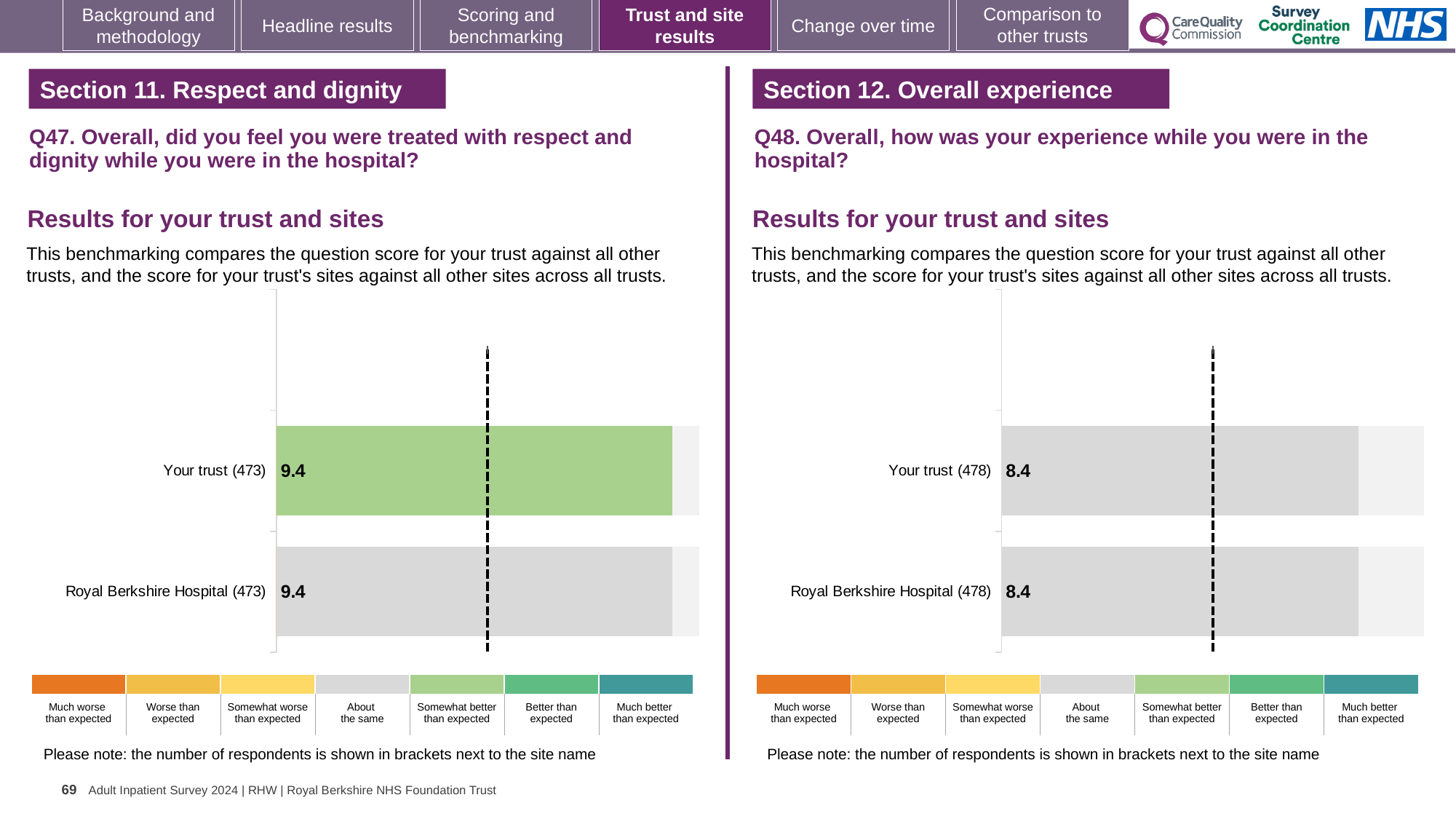
How many bars are plotted in the Q47 chart on the left? 2 In the Q48 chart on the right, what is the difference between the Your trust score and the Royal Berkshire Hospital score? 0.0 In the Q47 chart on the left, what is the score for Royal Berkshire Hospital? 9.4 In the Q48 chart on the right, what is the score for Your trust? 8.4 In the Q47 chart on the left, which benchmark category does the green colour of the Your trust bar correspond to in the legend? Somewhat better than expected In the Q48 chart on the right, what is the score for Royal Berkshire Hospital? 8.4 In the Q47 chart on the left, what is the difference between the Your trust score and the Royal Berkshire Hospital score? 0.0 In the Q47 chart on the left, what is the score for Your trust? 9.4 How many bars are plotted in the Q48 chart on the right? 2 In the Q48 chart on the right, how many respondents are shown in brackets next to Royal Berkshire Hospital? 478 What kind of chart is the Q47 chart on the left? Bar chart In the Q47 chart on the left, how many respondents are shown in brackets next to Your trust? 473